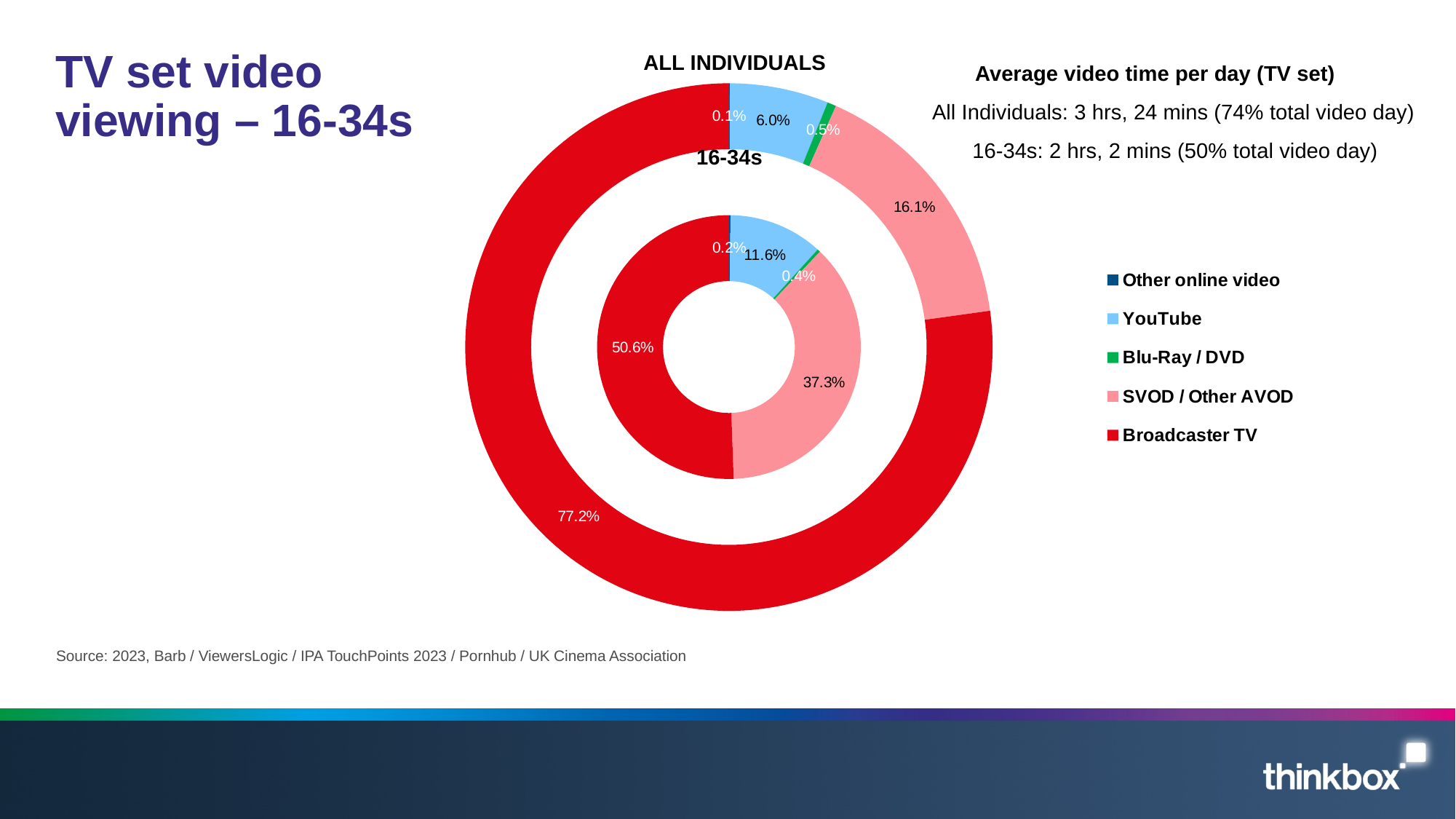
Which is larger: the YouTube share for 16-34s or the YouTube share for ALL INDIVIDUALS? 16-34s Which colour represents SVOD / Other AVOD in the chart? Light pink How many series does the legend list? 5 What kind of chart is shown on the slide? Doughnut chart In the 16-34s ring, what share is YouTube? 11.6% In the ALL INDIVIDUALS ring, what share is Blu-Ray / DVD? 0.5% In the 16-34s ring, what share is Other online video? 0.2% Which category has the largest share in the 16-34s ring? Broadcaster TV In the 16-34s ring, what share is SVOD / Other AVOD? 37.3% In the ALL INDIVIDUALS ring, what share is Broadcaster TV? 77.2% What is the difference between the Broadcaster TV share for ALL INDIVIDUALS and for 16-34s? 26.6 percentage points Which category has the smallest share in the ALL INDIVIDUALS ring? Other online video